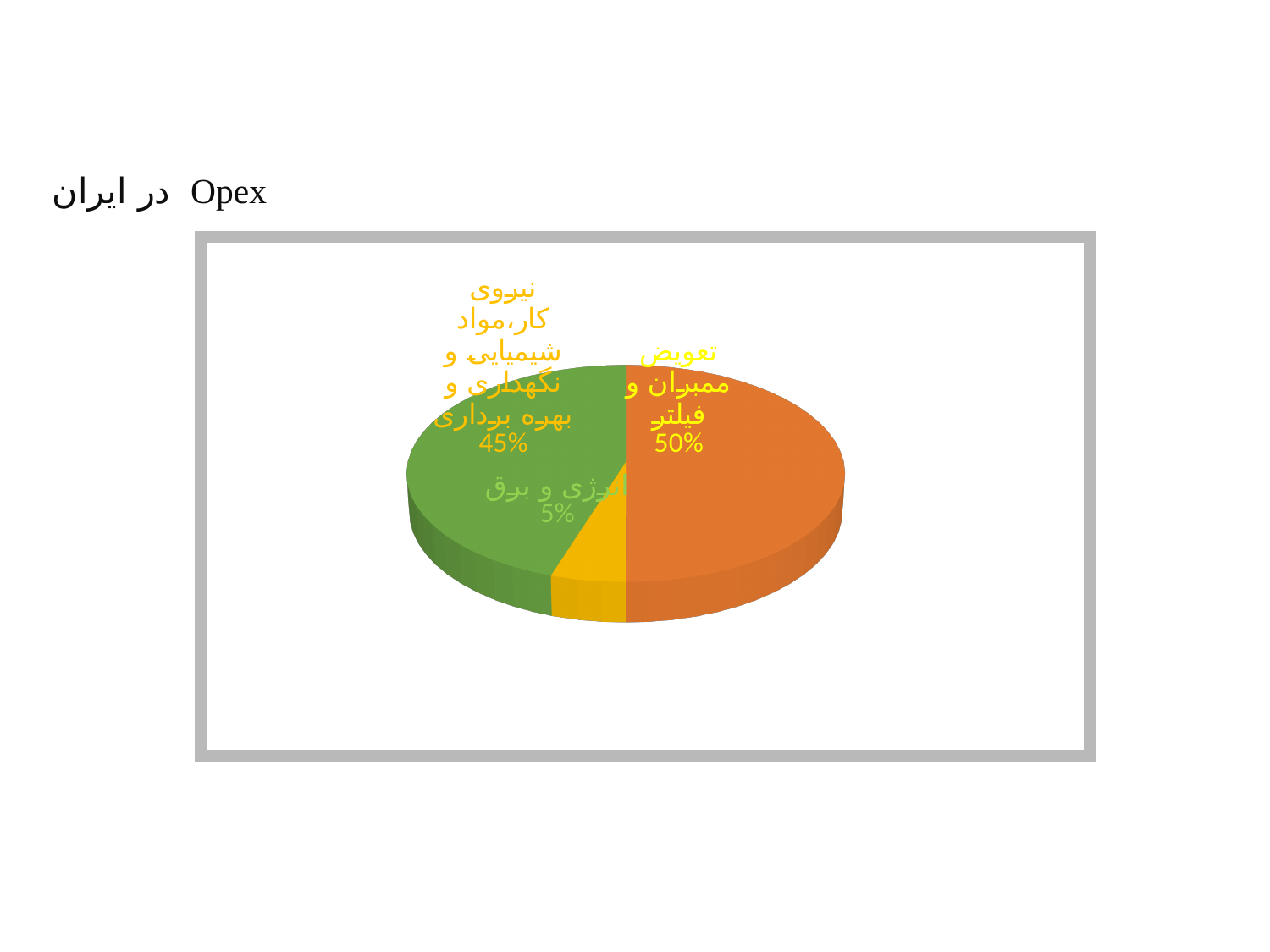
What share of the pie does "انرژی و برق" have? 5% What colour is the "انرژی و برق" slice? Yellow What kind of chart is shown on the slide? Pie chart What is the difference in percentage points between "تعویض ممبران و فیلتر" and "نیروی کار،مواد شیمیایی و نگهداری و بهره برداری"? 5% What is the title shown above the chart? Opex در ایران What share of the pie does "تعویض ممبران و فیلتر" have? 50% Which is larger: the share for "نیروی کار،مواد شیمیایی و نگهداری و بهره برداری" or the share for "انرژی و برق"? نیروی کار،مواد شیمیایی و نگهداری و بهره برداری How many slices does the pie chart have? 3 What share of the pie does "نیروی کار،مواد شیمیایی و نگهداری و بهره برداری" have? 45% Which slice of the pie chart is the smallest? انرژی و برق What is the difference in percentage points between "تعویض ممبران و فیلتر" and "انرژی و برق"? 45% Which slice of the pie chart is the largest? تعویض ممبران و فیلتر